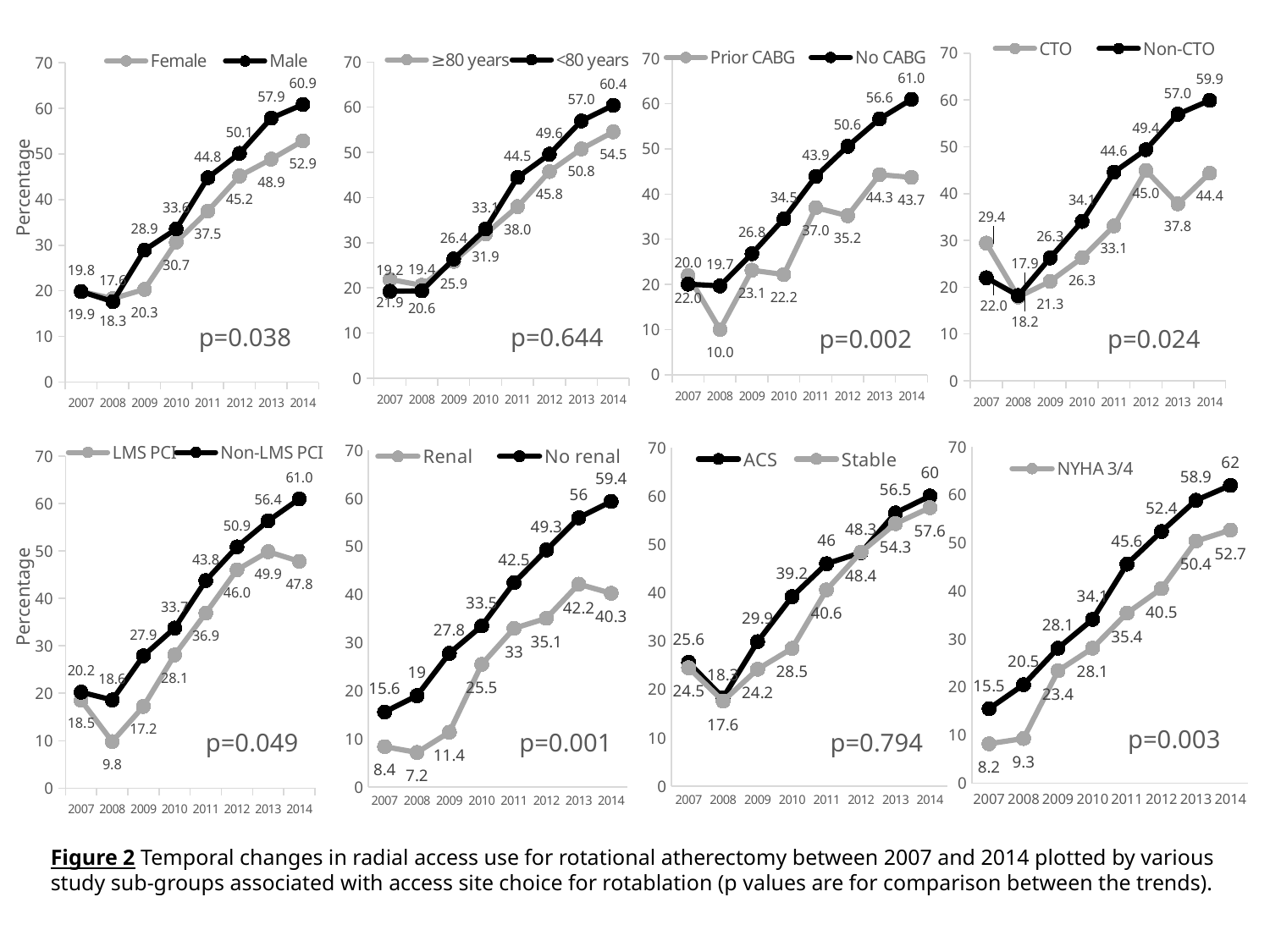
In the LMS PCI/Non-LMS PCI chart (bottom left), what is the value for LMS PCI in 2008? 9.8 What p value is shown on the ≥80 years/<80 years chart (top row, second from left)? p=0.644 In the Female/Male chart (top left), what is the value for Male in 2014? 60.9 In the Renal/No renal chart (bottom row, second from left), which year has the highest value for Renal? 2013 In the ACS/Stable chart (bottom row, third from left), what is the difference between ACS and Stable in 2014? 2.4 How many years are plotted on the x axis of each chart? 8 What kind of chart is used in each panel of the slide? Line chart In the NYHA 3/4 chart (bottom right), what is the value for NYHA 3/4 in 2013? 50.4 In the Female/Male chart (top left), what is the value for Female in 2010? 30.7 In the CTO/Non-CTO chart (top right), which is larger in 2007, CTO or Non-CTO? CTO In the Prior CABG/No CABG chart (top row, third from left), which year has the lowest value for Prior CABG? 2008 In the Prior CABG/No CABG chart (top row, third from left), what is the difference between No CABG and Prior CABG in 2014? 17.3